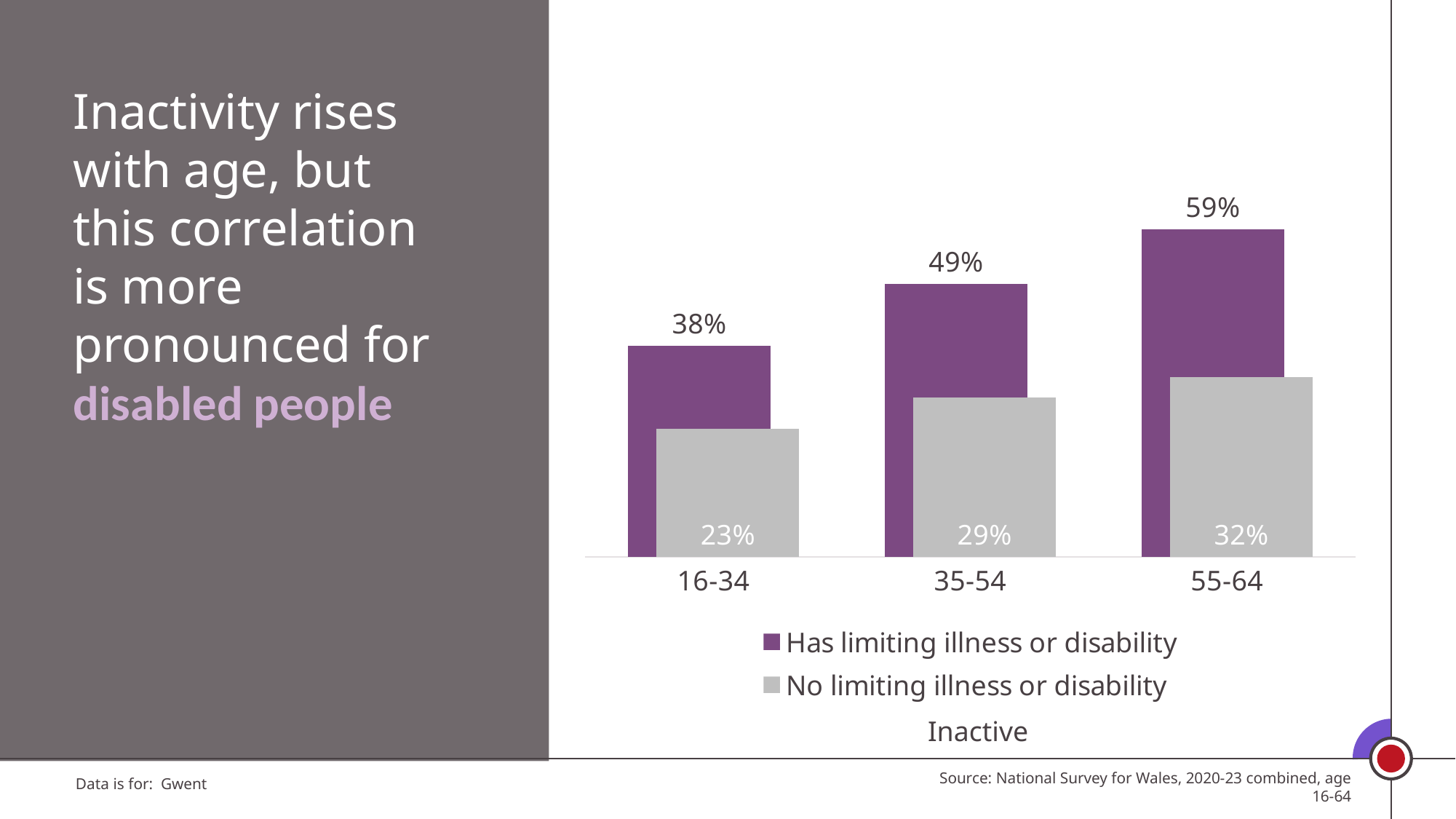
What kind of chart is shown on the slide? Bar chart What is the difference in inactivity rate between the 35-54 and 16-34 age groups for people with a limiting illness or disability? 11 percentage points What is the inactivity rate for people aged 55-64 with no limiting illness or disability? 32% What is the difference in inactivity rate between people with and without a limiting illness or disability in the 55-64 age group? 27 percentage points How many series does the legend list? 2 Which age group has the highest inactivity rate among people with a limiting illness or disability? 55-64 In the 35-54 age group, which is larger: the inactivity rate for people with a limiting illness or disability, or for those without? Has limiting illness or disability What is the inactivity rate for people aged 16-34 who have a limiting illness or disability? 38% Which age group has the lowest inactivity rate among people with no limiting illness or disability? 16-34 Do inactivity rates rise or fall as age increases for people with no limiting illness or disability? Rise How many age groups are shown on the chart? 3 What is the inactivity rate for people aged 35-54 who have a limiting illness or disability? 49%